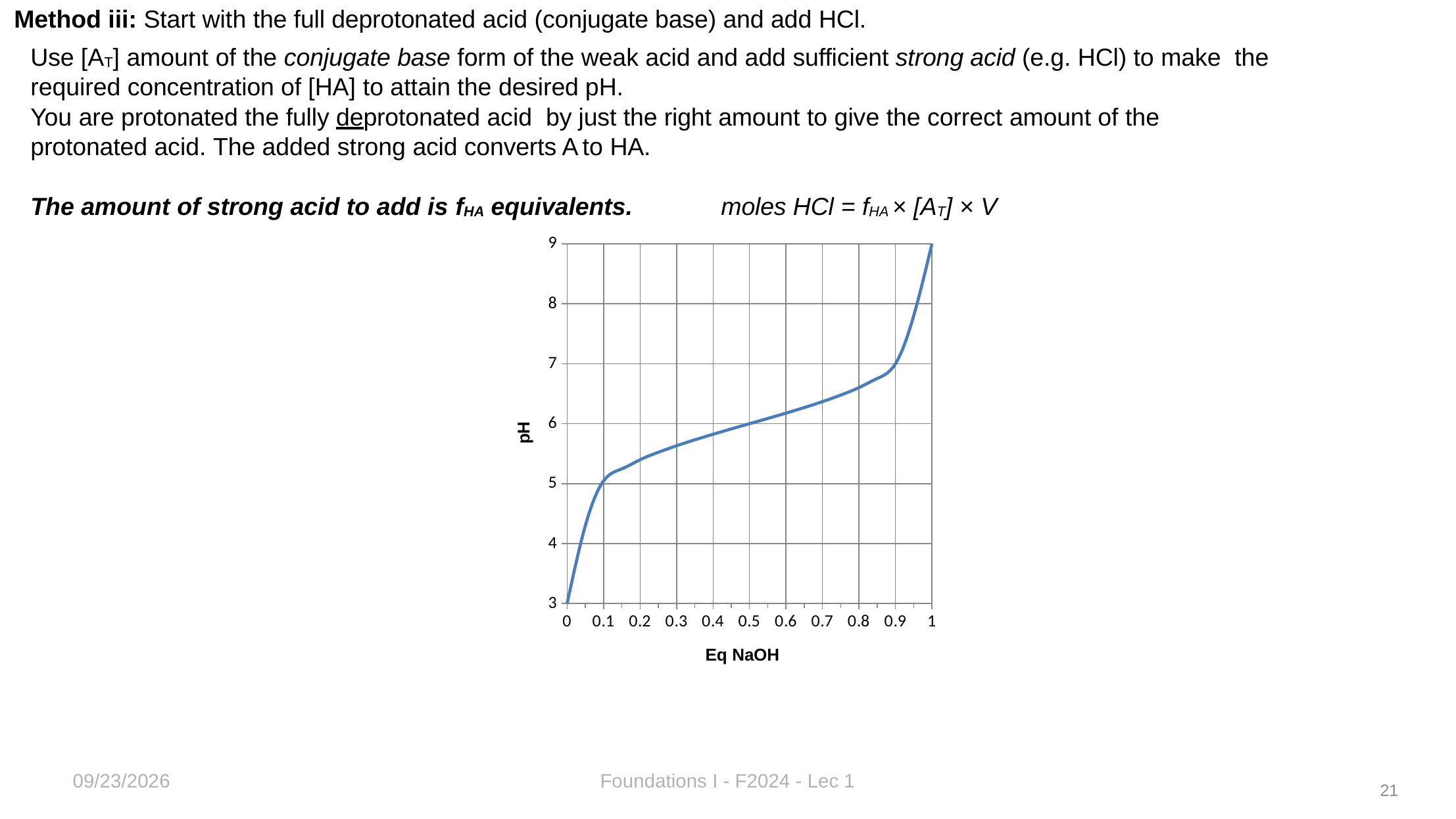
Is the pH at 0.8 Eq NaOH greater or less than 7? less What is the label of the y axis of the chart? pH Is the pH at 0.2 Eq NaOH greater or less than 5? greater What is the pH at 1 Eq NaOH, where the curve ends? 9 Is the pH at 0.7 Eq NaOH greater or less than 6? greater What is the pH at 0 Eq NaOH, where the curve starts? 3 What kind of chart is shown on the slide? line chart Does the pH rise or fall as Eq NaOH increases from 0 to 1? rise At which Eq NaOH value is the pH highest? 1 What is the label of the x axis of the chart? Eq NaOH Which has the higher pH: 0.2 Eq NaOH or 0.8 Eq NaOH? 0.8 Eq NaOH